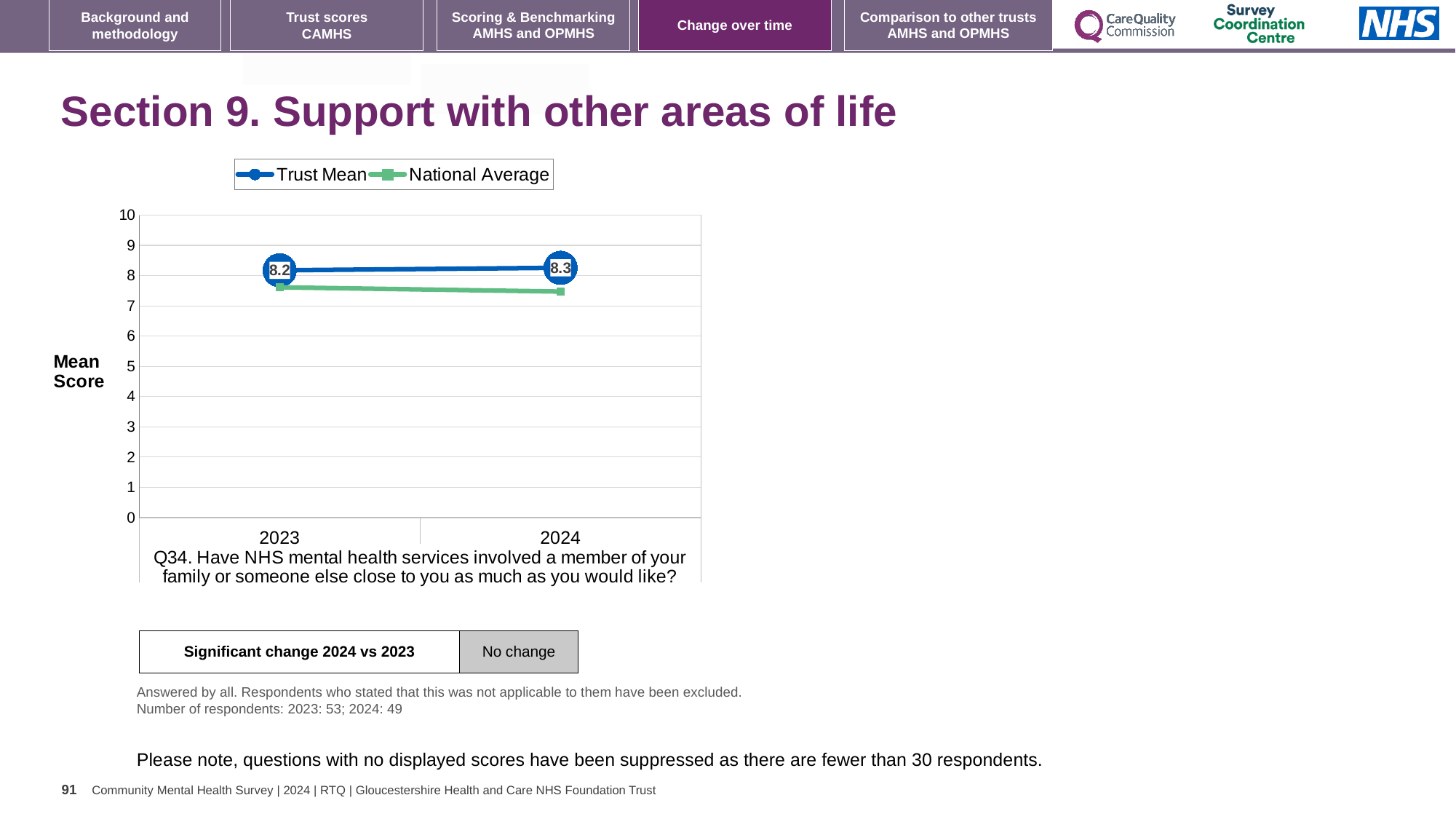
Is the National Average value for 2024 greater or less than 7? greater In 2024, which is larger, the Trust Mean or the National Average? Trust Mean What is the Trust Mean score for 2024? 8.3 What is the Trust Mean score for 2023? 8.2 What kind of chart is shown on the slide? line chart In which year is the Trust Mean score higher, 2023 or 2024? 2024 How many years are shown on the x axis? 2 What is the difference between the Trust Mean scores for 2024 and 2023? 0.1 Is the National Average value for 2023 greater or less than 8? less What is the label of the y axis? Mean Score Does the Trust Mean rise or fall from 2023 to 2024? rise How many series does the legend list? 2